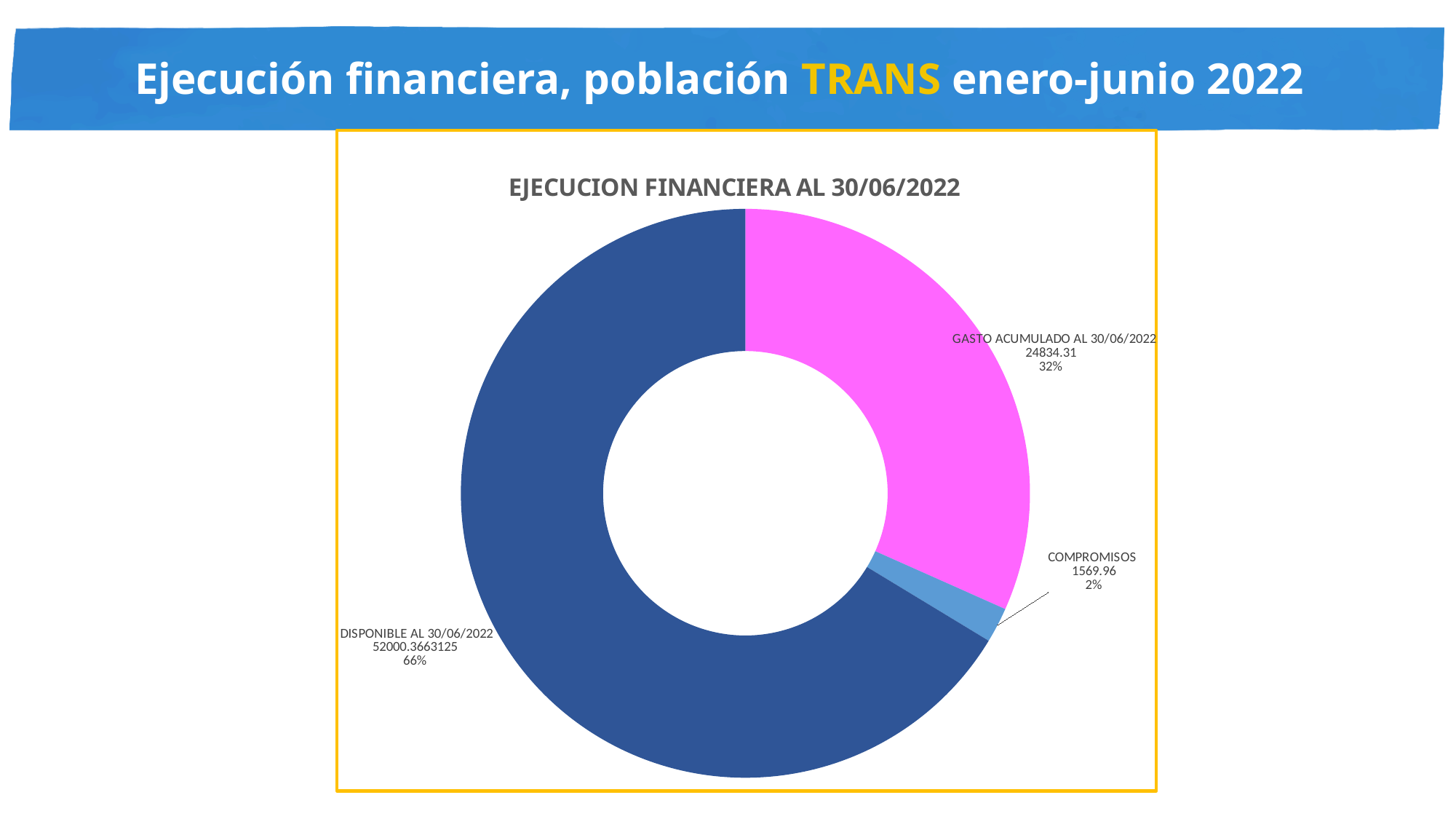
Which is larger, GASTO ACUMULADO AL 30/06/2022 or COMPROMISOS? GASTO ACUMULADO AL 30/06/2022 What type of chart is shown on the slide? Doughnut chart What is the value for GASTO ACUMULADO AL 30/06/2022? 24834.31 Which category has the smallest slice? COMPROMISOS What share of the chart does GASTO ACUMULADO AL 30/06/2022 represent? 32% How many slices does the chart have? 3 What is the title of the chart? EJECUCION FINANCIERA AL 30/06/2022 Which category has the largest slice? DISPONIBLE AL 30/06/2022 What share of the chart does DISPONIBLE AL 30/06/2022 represent? 66% What is the value for DISPONIBLE AL 30/06/2022? 52000.3663125 What is the value for COMPROMISOS? 1569.96 What share of the chart does COMPROMISOS represent? 2%